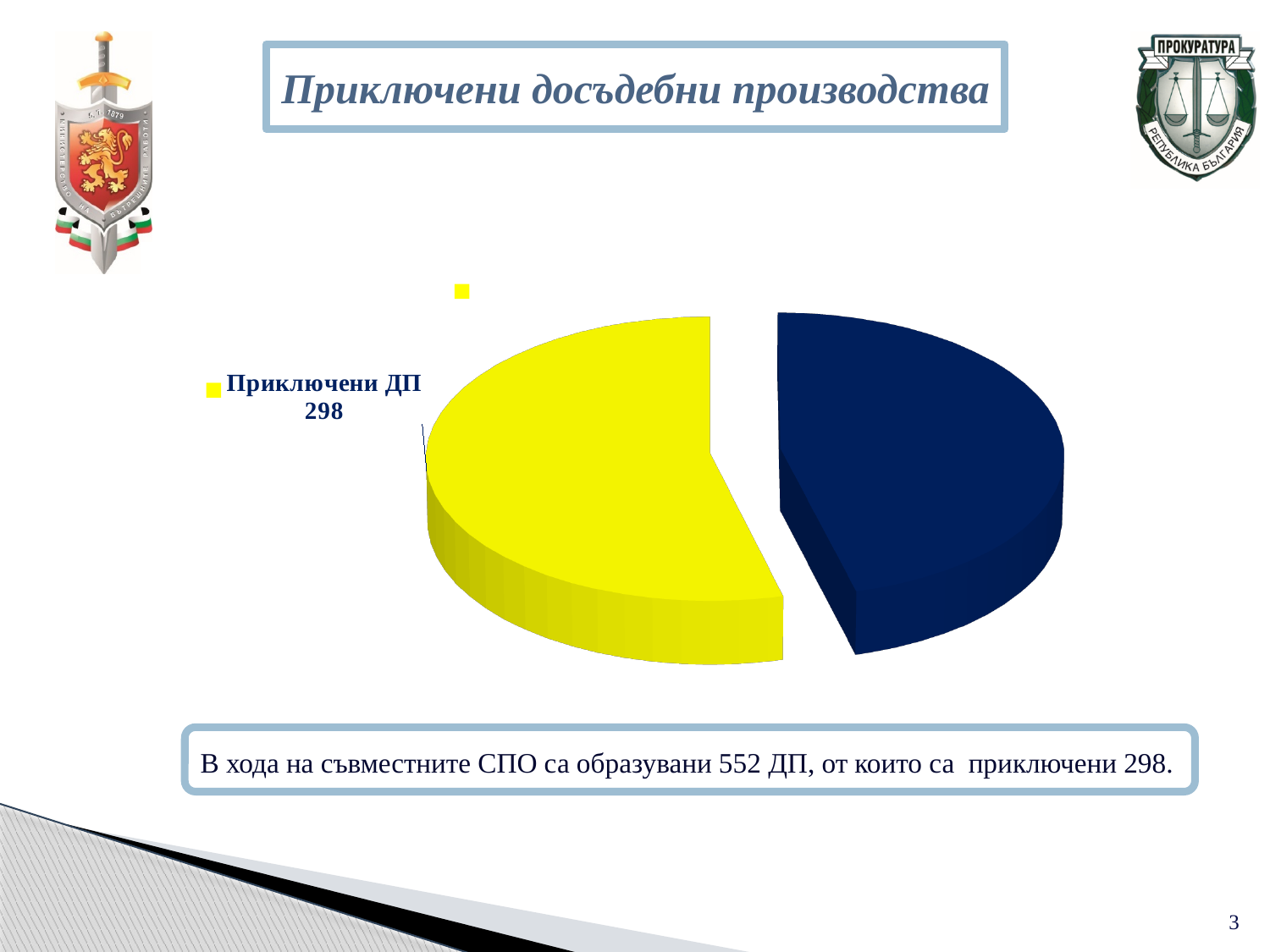
What kind of chart is shown on the slide? pie chart Which labelled category has the largest slice in the pie chart? Приключени ДП What is the value shown for Приключени ДП? 298 What colour is the slice for Приключени ДП? yellow What is the title of the slide containing the pie chart? Приключени досъдебни производства How many slices does the pie chart have? 2 Which slice of the pie chart is larger, the yellow one or the dark blue one? the yellow one